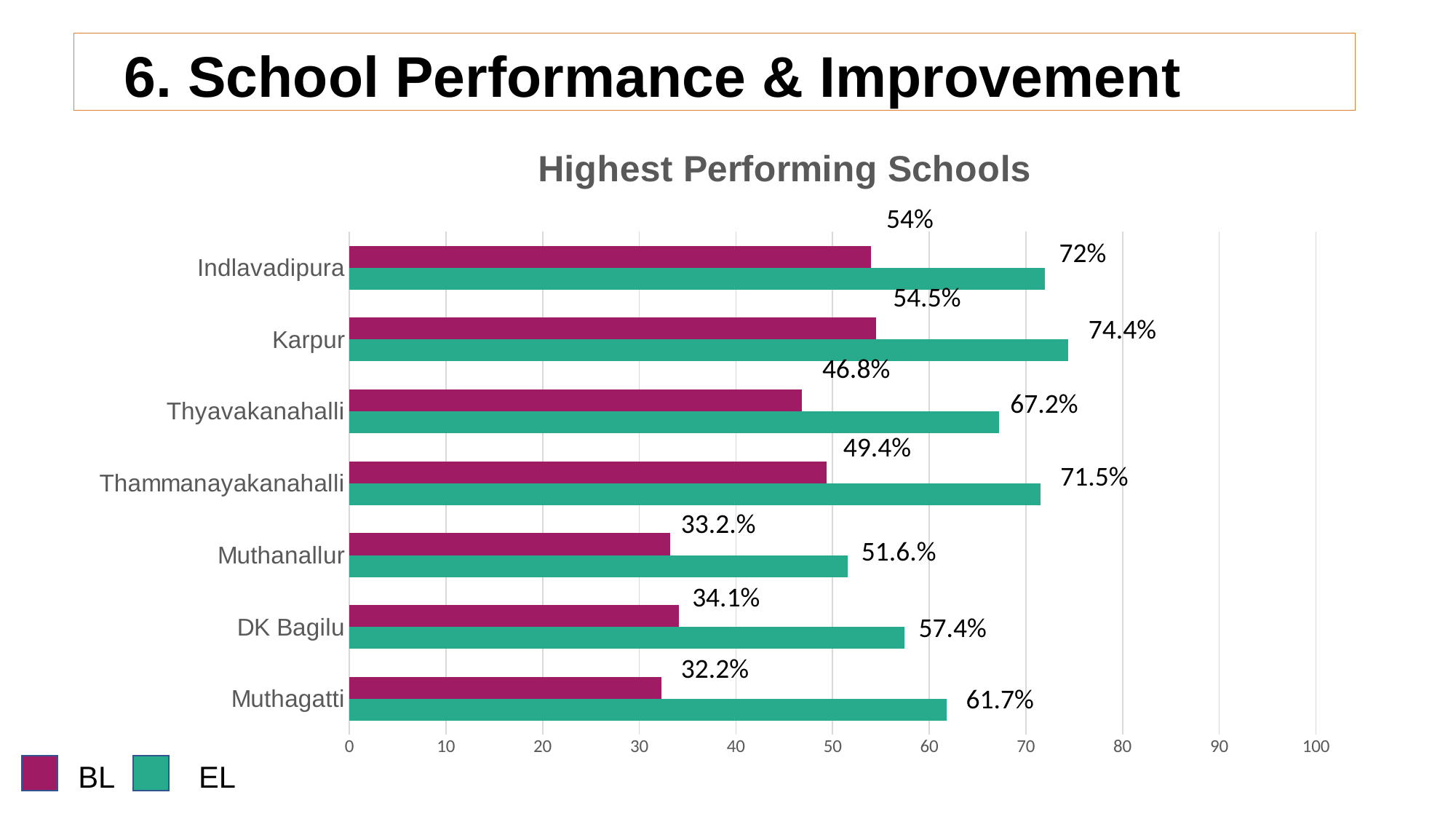
Which school has the lowest BL value? Muthagatti What is the EL value for Karpur? 74.4% What is the difference between the EL and BL values for Indlavadipura? 18% How many schools are shown on the chart? 7 What type of chart is shown on the slide? Bar chart How many series does the legend list? 2 What is the title of the chart? Highest Performing Schools Is the BL value for Thammanayakanahalli greater or less than 50? less Which is larger, the EL value for DK Bagilu or the EL value for Muthagatti? Muthagatti Which school has the highest EL value? Karpur What is the EL value for Muthagatti? 61.7% What is the BL value for Thyavakanahalli? 46.8%